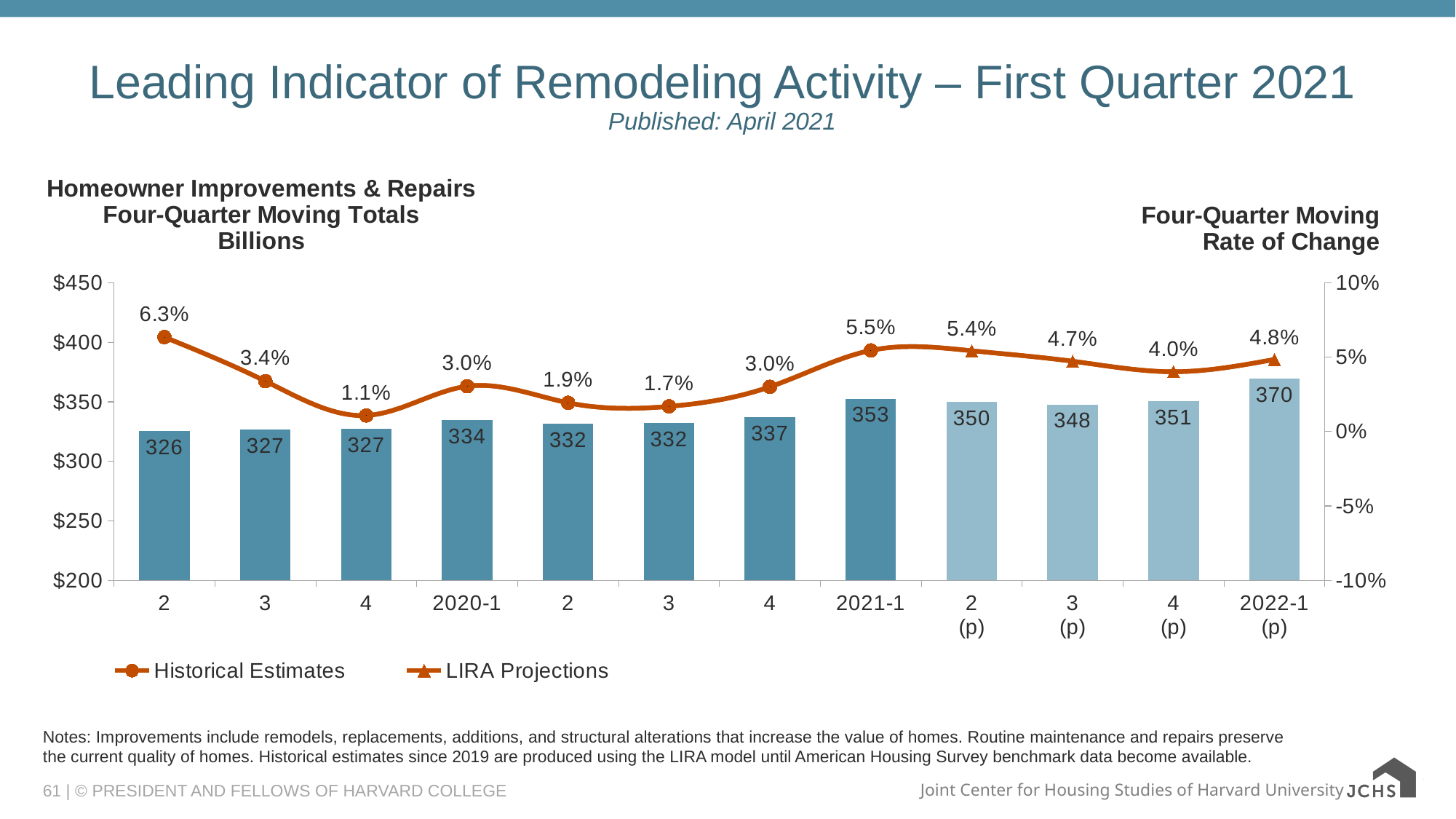
Which period has the highest four-quarter moving total bar? 2022-1 (p) What kind of chart is shown on the slide? Combination bar and line chart Does the four-quarter moving rate of change rise or fall from 2021-1 to 4 (p)? Fall What is the lowest four-quarter moving rate of change shown on the line? 1.1% What is the four-quarter moving total (in billions) for 2021-1? 353 How many series does the legend list? 2 What is the difference between the four-quarter moving total for 2022-1 (p) and for 2021-1? 17 How many quarters are shown along the x axis? 12 Is the four-quarter moving total bar for 2022-1 (p) greater or less than $350? greater Which has the larger four-quarter moving total: 2021-1 or 2 (p)? 2021-1 What is the four-quarter moving rate of change for 2020-1? 3.0% What are the two entries in the chart legend? Historical Estimates and LIRA Projections